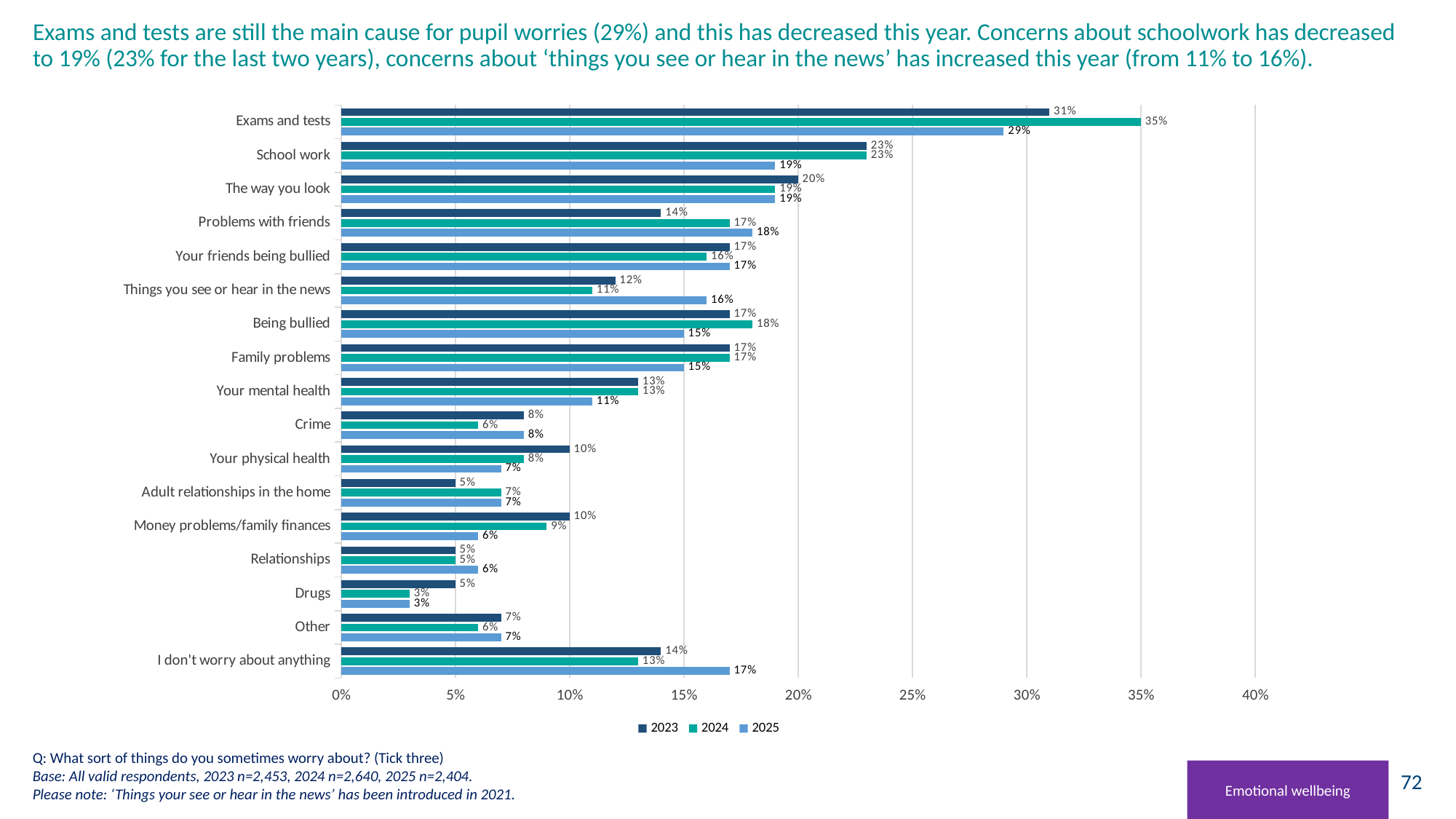
What kind of chart is shown on the slide? Bar chart What is the difference between the 2024 and 2025 values for 'Exams and tests'? 6% Do the values for 'Things you see or hear in the news' rise or fall from 2024 to 2025? Rise Which category has the lowest 2025 value? Drugs Which is larger for 'I don't worry about anything': the 2023 value or the 2025 value? 2025 How many categories are plotted on the chart? 17 What is the 2025 value for 'Exams and tests'? 29% How many series does the legend list? 3 Which category has the highest 2024 value? Exams and tests What is the 2023 value for 'Money problems/family finances'? 10% What is the 2024 value for 'Things you see or hear in the news'? 11% Which series is shown in the darkest blue colour in the legend? 2023